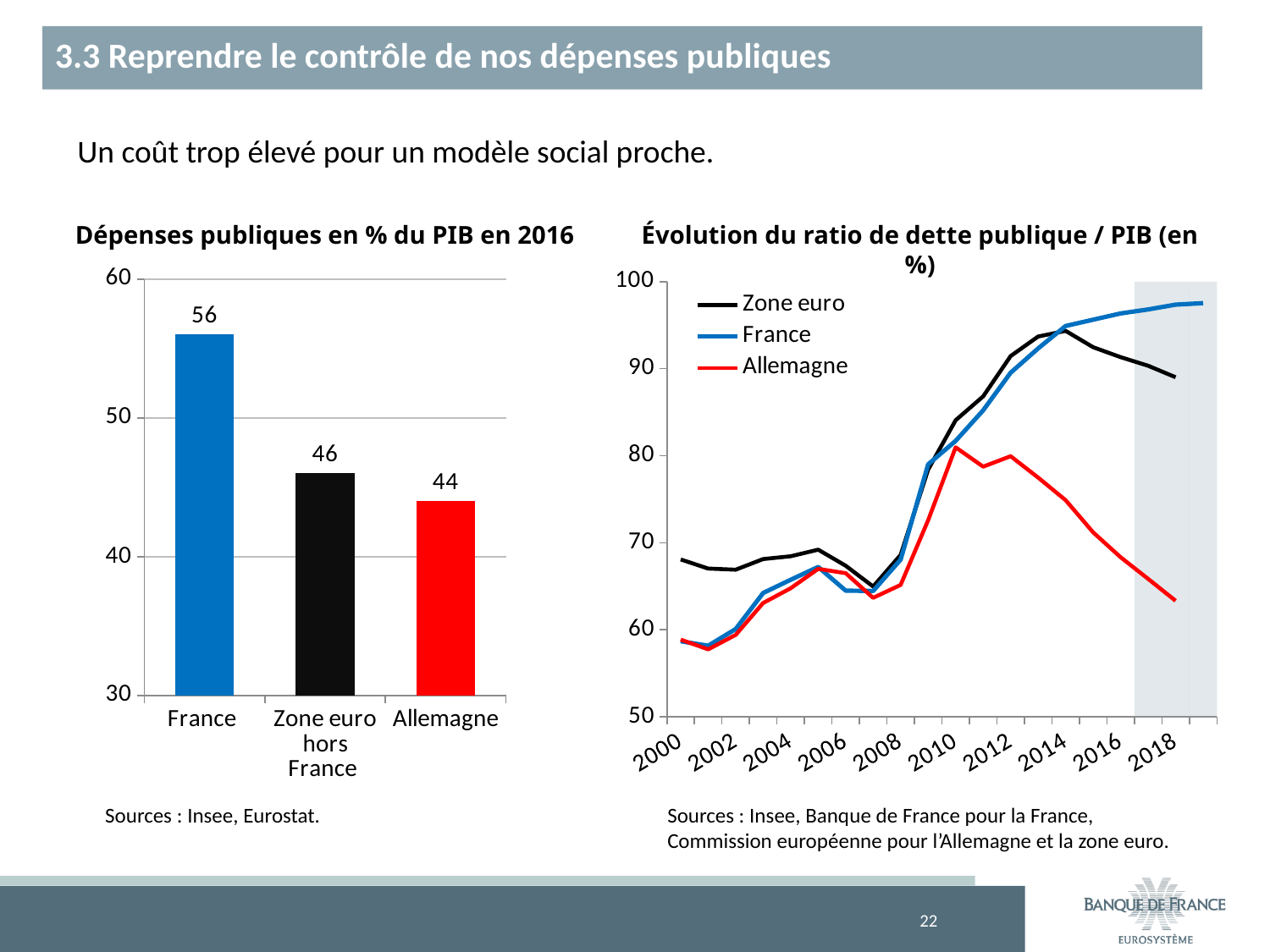
In the chart 'Dépenses publiques en % du PIB en 2016', what is the value for France? 56 What kind of chart is the chart 'Évolution du ratio de dette publique / PIB (en %)'? Line chart In the chart 'Évolution du ratio de dette publique / PIB (en %)', how many series does the legend list? 3 In the chart 'Dépenses publiques en % du PIB en 2016', what is the difference between the values for France and Allemagne? 12 In the chart 'Dépenses publiques en % du PIB en 2016', what is the value for Allemagne? 44 In the chart 'Évolution du ratio de dette publique / PIB (en %)', which series has the highest value in 2018, France or Allemagne? France In the chart 'Évolution du ratio de dette publique / PIB (en %)', is the value for Allemagne in 2018 greater or less than 70? less In the chart 'Dépenses publiques en % du PIB en 2016', which category has the highest value? France In the chart 'Dépenses publiques en % du PIB en 2016', what is the value for Zone euro hors France? 46 In the chart 'Dépenses publiques en % du PIB en 2016', how many categories are shown? 3 In the chart 'Dépenses publiques en % du PIB en 2016', which category has the lowest value? Allemagne What kind of chart is the chart on the left of the slide? Bar chart